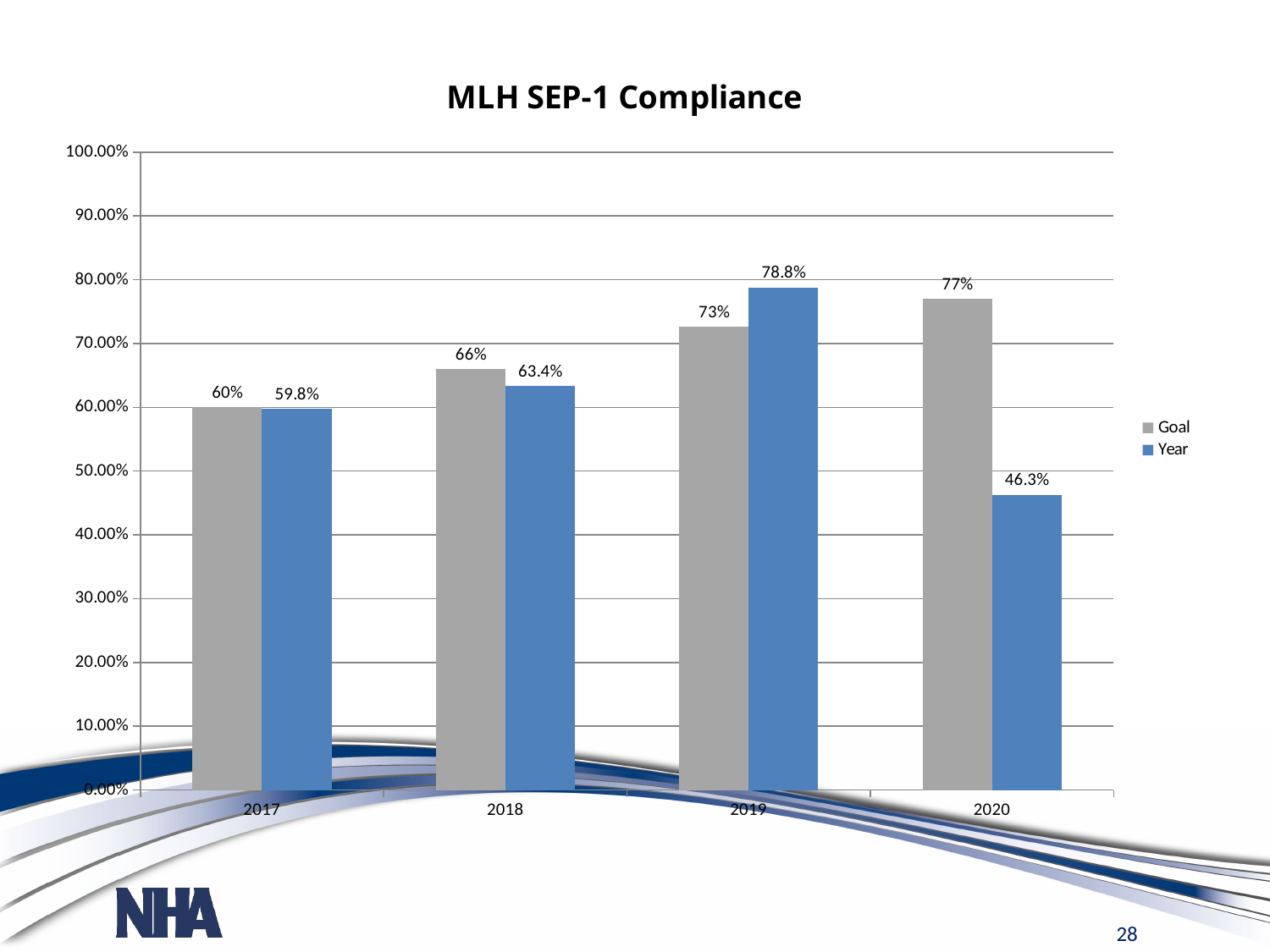
What is the difference between the Goal and Year values for 2020? 30.7% Which year has the lowest Year value? 2020 How many series does the legend list? 2 What is the Year value for 2020? 46.3% What is the title of the chart? MLH SEP-1 Compliance Which year has the highest Year value? 2019 Is the Year value for 2020 greater or less than 50.00%? less Which is larger for 2019, the Goal value or the Year value? Year What is the Year value for 2018? 63.4% What kind of chart is shown? bar chart How many years are shown on the x axis? 4 What is the Goal value for 2019? 73%